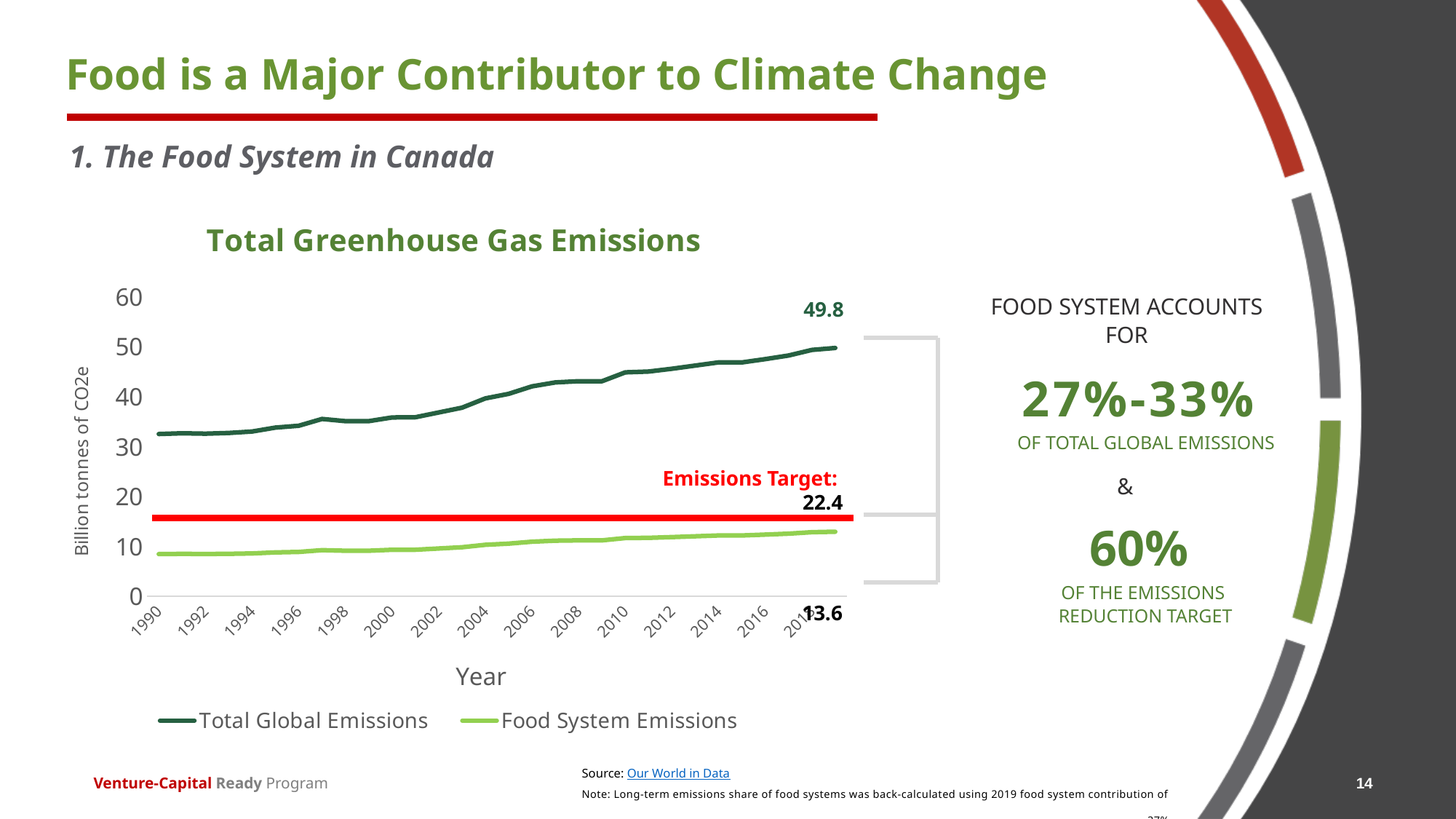
What value is given for the Emissions Target line on the chart? 22.4 Does the Total Global Emissions line rise or fall from 1990 to 2018? rise Which is larger: the Emissions Target (22.4) or the 2018 Food System Emissions (13.6)? Emissions Target Is the value for Total Global Emissions in 2000 greater or less than 40? less Does the Food System Emissions line rise or fall from 1990 to 2018? rise What is the difference between the 2018 Total Global Emissions (49.8) and the 2018 Food System Emissions (13.6)? 36.2 What kind of chart is shown under the title "Total Greenhouse Gas Emissions"? line chart What is the labelled value of Total Global Emissions at the end of the series in 2018? 49.8 What is the labelled value of Food System Emissions at the end of the series in 2018? 13.6 Is the value for Total Global Emissions in 1990 greater or less than 30? greater How many series does the legend of the "Total Greenhouse Gas Emissions" chart list? 2 What is the label on the vertical axis of the chart? Billion tonnes of CO2e